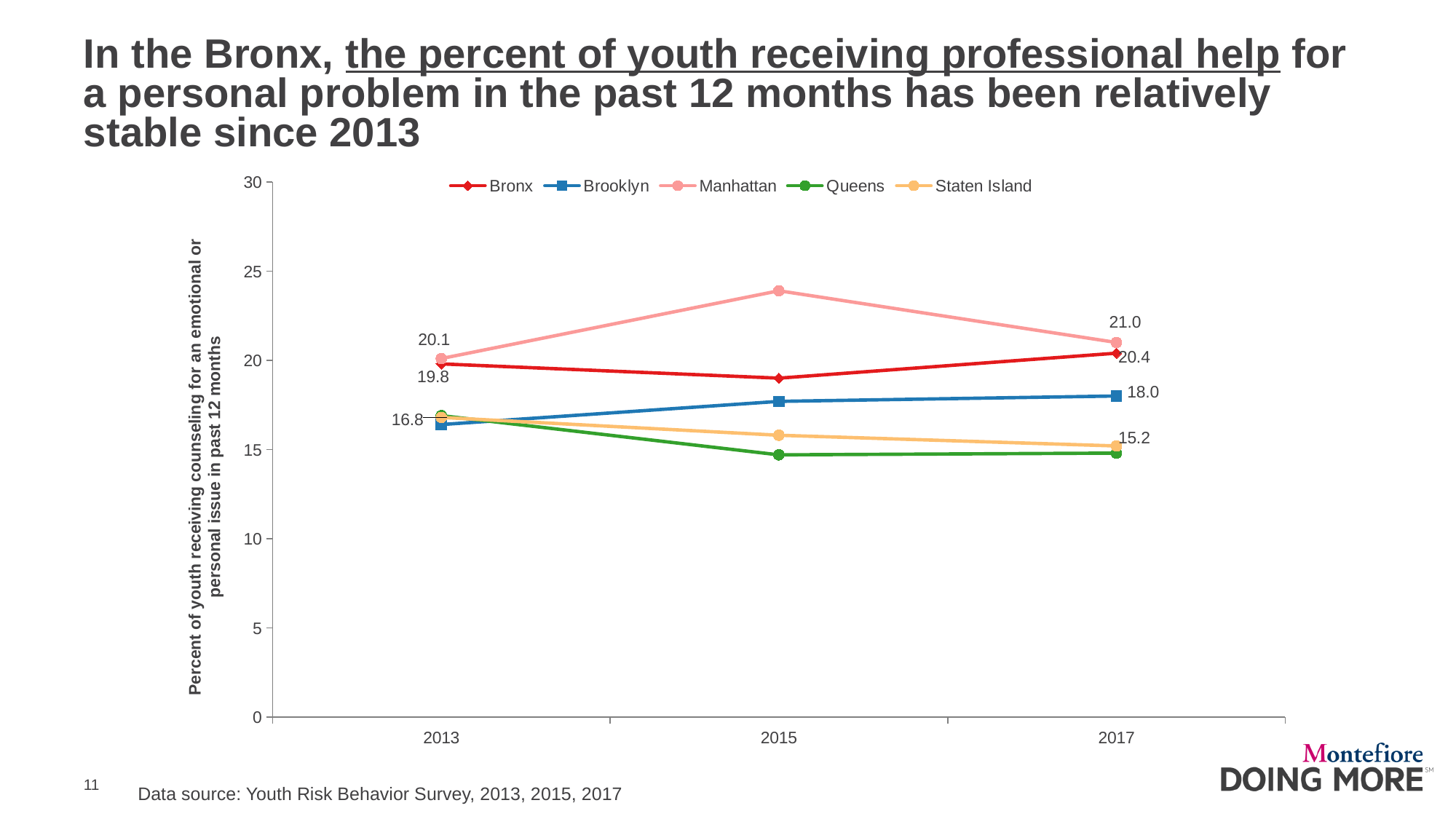
What is the value for Brooklyn in 2017? 18.0 How many years are plotted along the x axis? 3 By how much did the Bronx value change from 2013 to 2017? 0.6 What is the value for the Bronx in 2017? 20.4 Is the value for Manhattan in 2015 greater or less than 20? greater Which borough has the highest value in 2017? Manhattan What is the value for Staten Island in 2017? 15.2 What is the value for the Bronx in 2013? 19.8 Does the Brooklyn line rise or fall from 2013 to 2017? rise What is the value for Manhattan in 2017? 21.0 What kind of chart is shown on the slide? line chart How many series does the legend list? 5